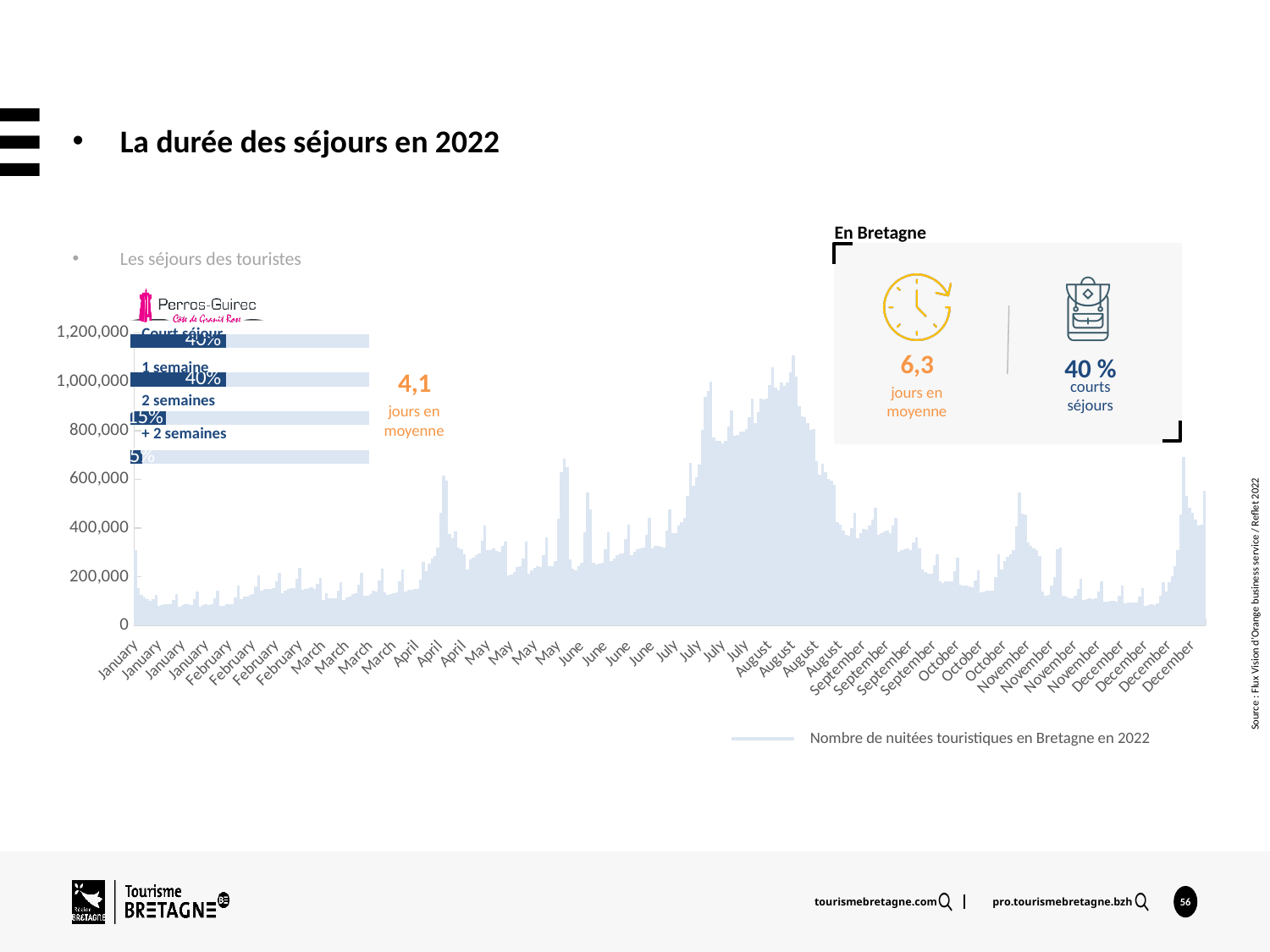
In the 'Nombre de nuitées touristiques en Bretagne en 2022' chart, do the values generally rise or fall from June to August? rise In the Perros-Guirec bar chart on the length of stays, what is the difference between '2 semaines' and '+ 2 semaines'? 10 percentage points In the Perros-Guirec bar chart on the length of stays, how many categories are shown? 4 In the 'Nombre de nuitées touristiques en Bretagne en 2022' chart, are the values in late January greater or less than 200,000? less In the Perros-Guirec bar chart on the length of stays, which category has the lowest value? + 2 semaines In the 'Nombre de nuitées touristiques en Bretagne en 2022' chart, is the highest peak in August greater or less than 1,000,000? greater In the Perros-Guirec bar chart on the length of stays, what is the value for '2 semaines'? 15% In the 'Nombre de nuitées touristiques en Bretagne en 2022' chart, what is the highest value shown on the vertical axis? 1,200,000 In the 'Nombre de nuitées touristiques en Bretagne en 2022' chart, how many series does the legend list? 1 In the 'Nombre de nuitées touristiques en Bretagne en 2022' chart, in which month does the number of nights reach its highest peak? August What kind of chart is the large chart showing 'Nombre de nuitées touristiques en Bretagne en 2022'? bar chart In the Perros-Guirec bar chart on the length of stays, what is the value for '1 semaine'? 40%